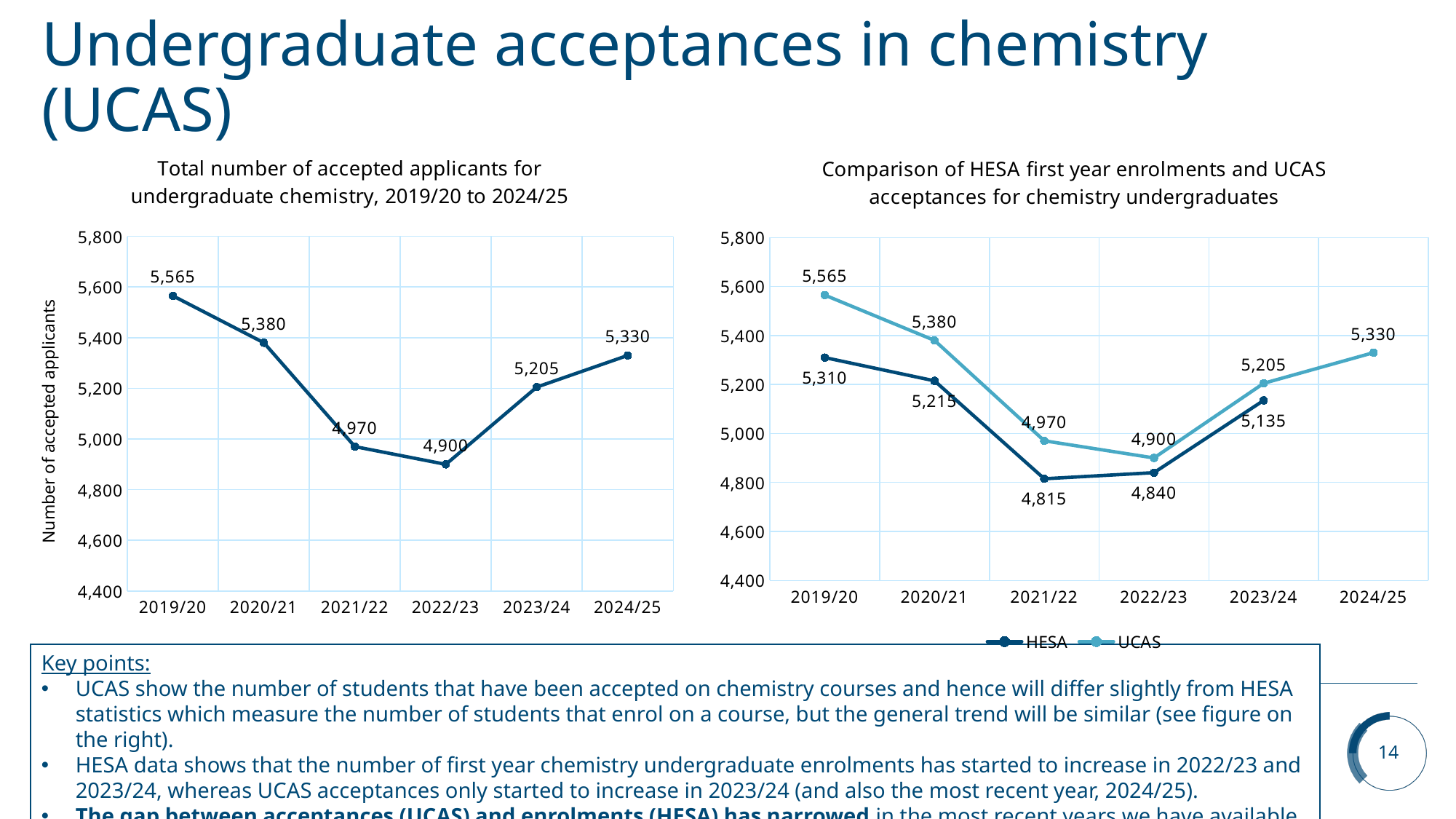
In the left chart, 'Total number of accepted applicants for undergraduate chemistry', which year has the highest value? 2019/20 In the right chart, 'Comparison of HESA first year enrolments and UCAS acceptances', what is the HESA value for 2023/24? 5,135 In the right chart, 'Comparison of HESA first year enrolments and UCAS acceptances', how many series does the legend list? 2 In the left chart, 'Total number of accepted applicants for undergraduate chemistry', what is the value for 2021/22? 4,970 In the left chart, 'Total number of accepted applicants for undergraduate chemistry', what is the difference between the 2019/20 and 2024/25 values? 235 What type of chart is the left chart, 'Total number of accepted applicants for undergraduate chemistry'? Line chart In the right chart, 'Comparison of HESA first year enrolments and UCAS acceptances', do the HESA values rise or fall from 2019/20 to 2021/22? Fall In the right chart, 'Comparison of HESA first year enrolments and UCAS acceptances', what is the HESA value for 2021/22? 4,815 In the right chart, 'Comparison of HESA first year enrolments and UCAS acceptances', which is larger in 2020/21, HESA or UCAS? UCAS In the right chart, 'Comparison of HESA first year enrolments and UCAS acceptances', what is the difference between the UCAS and HESA values in 2019/20? 255 In the left chart, 'Total number of accepted applicants for undergraduate chemistry', how many years are plotted? 6 In the left chart, 'Total number of accepted applicants for undergraduate chemistry', which year has the lowest value? 2022/23